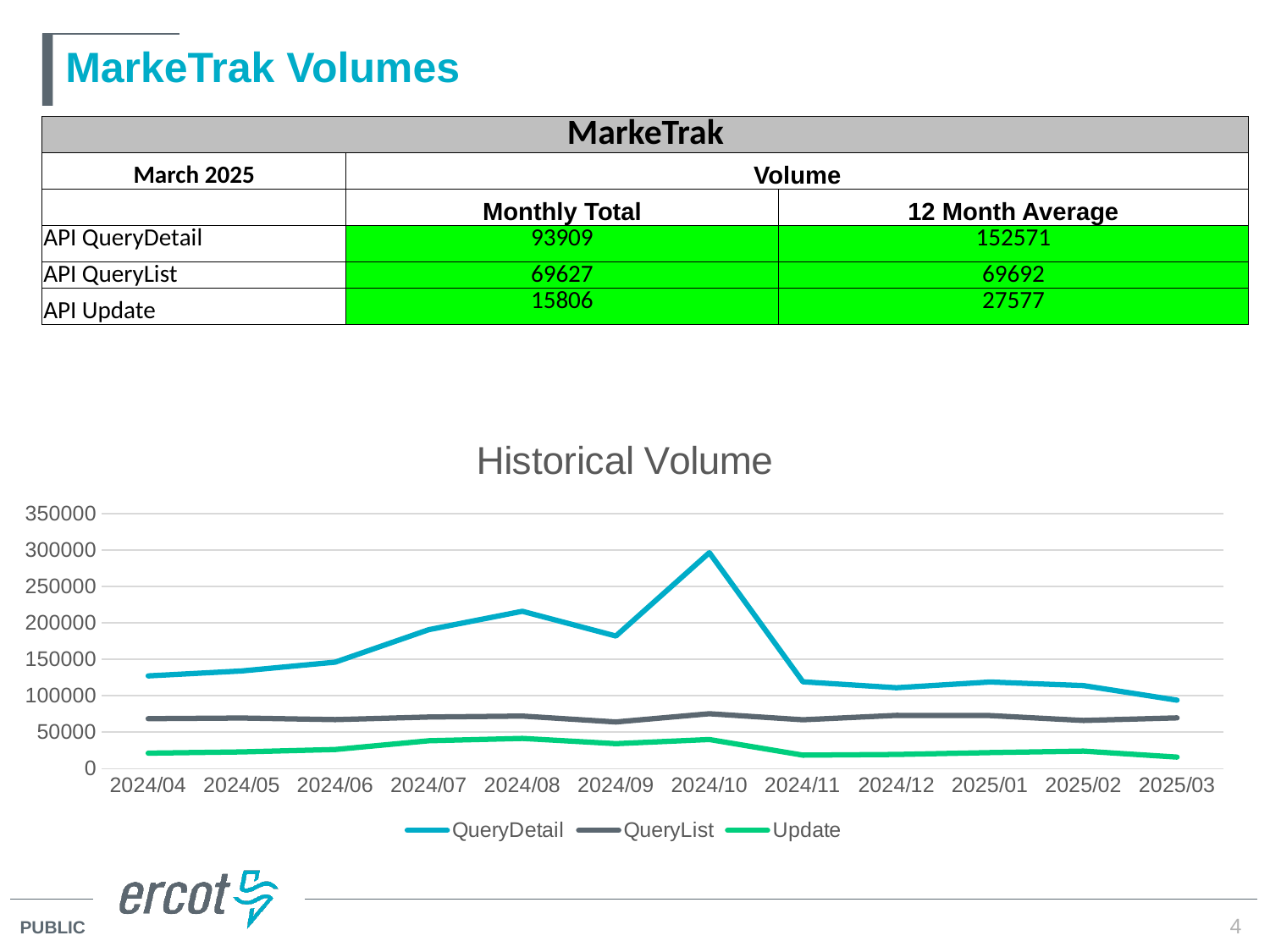
What are the legend entries of the Historical Volume chart? QueryDetail, QueryList, Update In the Historical Volume chart, is the QueryDetail value for 2024/10 greater or less than 250000? greater How many series does the legend of the Historical Volume chart list? 3 How many months are shown on the x axis of the Historical Volume chart? 12 In the Historical Volume chart, is the QueryDetail value for 2024/11 greater or less than 150000? less In the Historical Volume chart, which series has the lowest value at 2025/03? Update In the Historical Volume chart, does the QueryDetail line rise or fall from 2024/10 to 2024/11? fall In the Historical Volume chart, is the QueryList value for 2024/04 greater or less than 100000? less What kind of chart is the Historical Volume chart? line chart In the Historical Volume chart, which is larger at 2024/08: QueryDetail or Update? QueryDetail In the Historical Volume chart, in which month does QueryDetail reach its highest value? 2024/10